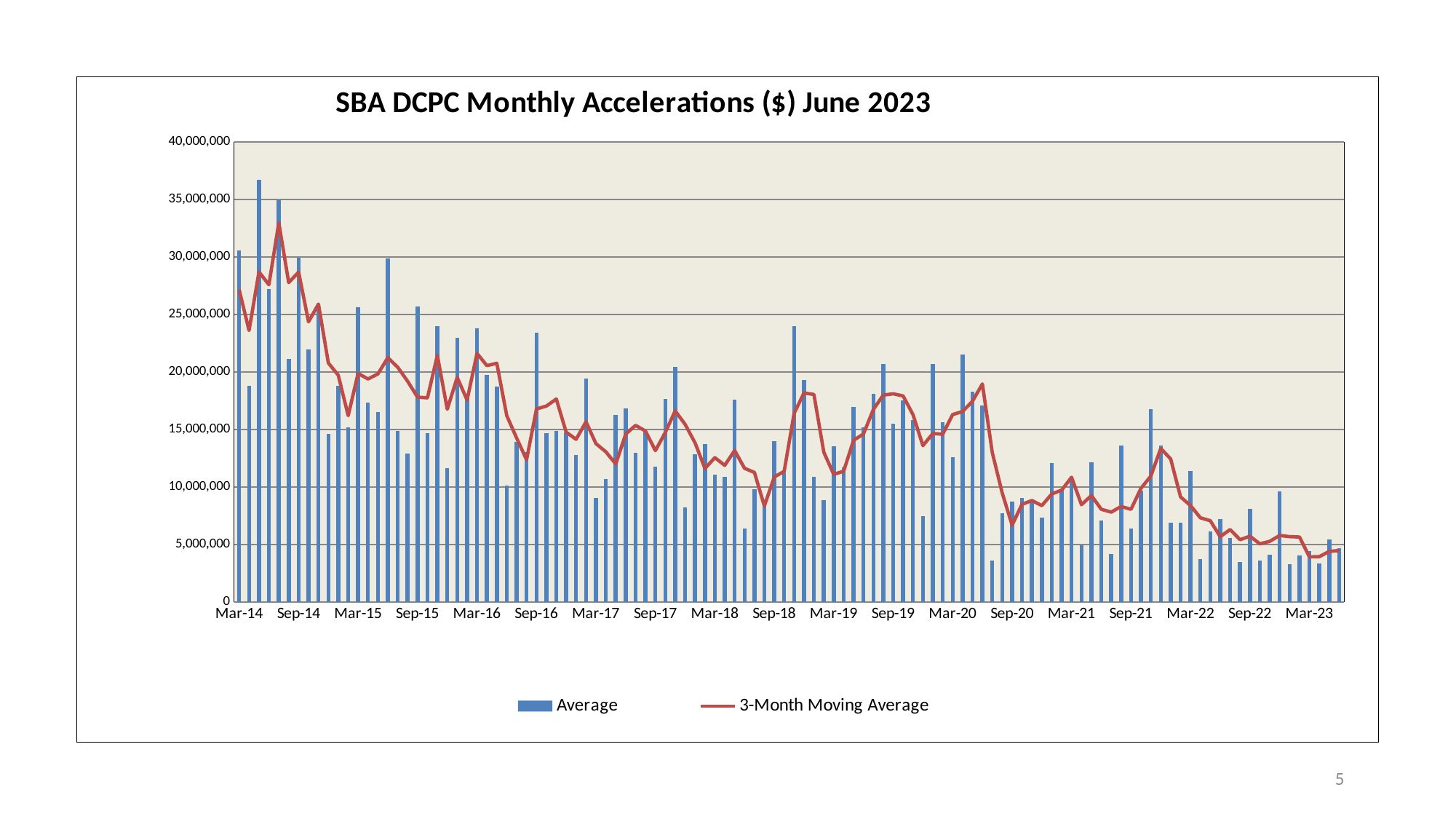
Is the Average value for Sep-20 greater or less than 10,000,000? less What is the highest value shown on the y axis? 40,000,000 How many series does the legend list? 2 Overall, do the Average bars rise or fall from Mar-14 to Mar-23? Fall Is the Average value for Mar-14 greater or less than 25,000,000? greater What does the red line in the chart represent, according to the legend? 3-Month Moving Average Is the 3-Month Moving Average at Sep-20 greater or less than 10,000,000? less What is the title of the chart? SBA DCPC Monthly Accelerations ($) June 2023 What kind of chart is shown on the slide? Bar chart with a line overlay Which has the larger Average value, Mar-14 or Mar-23? Mar-14